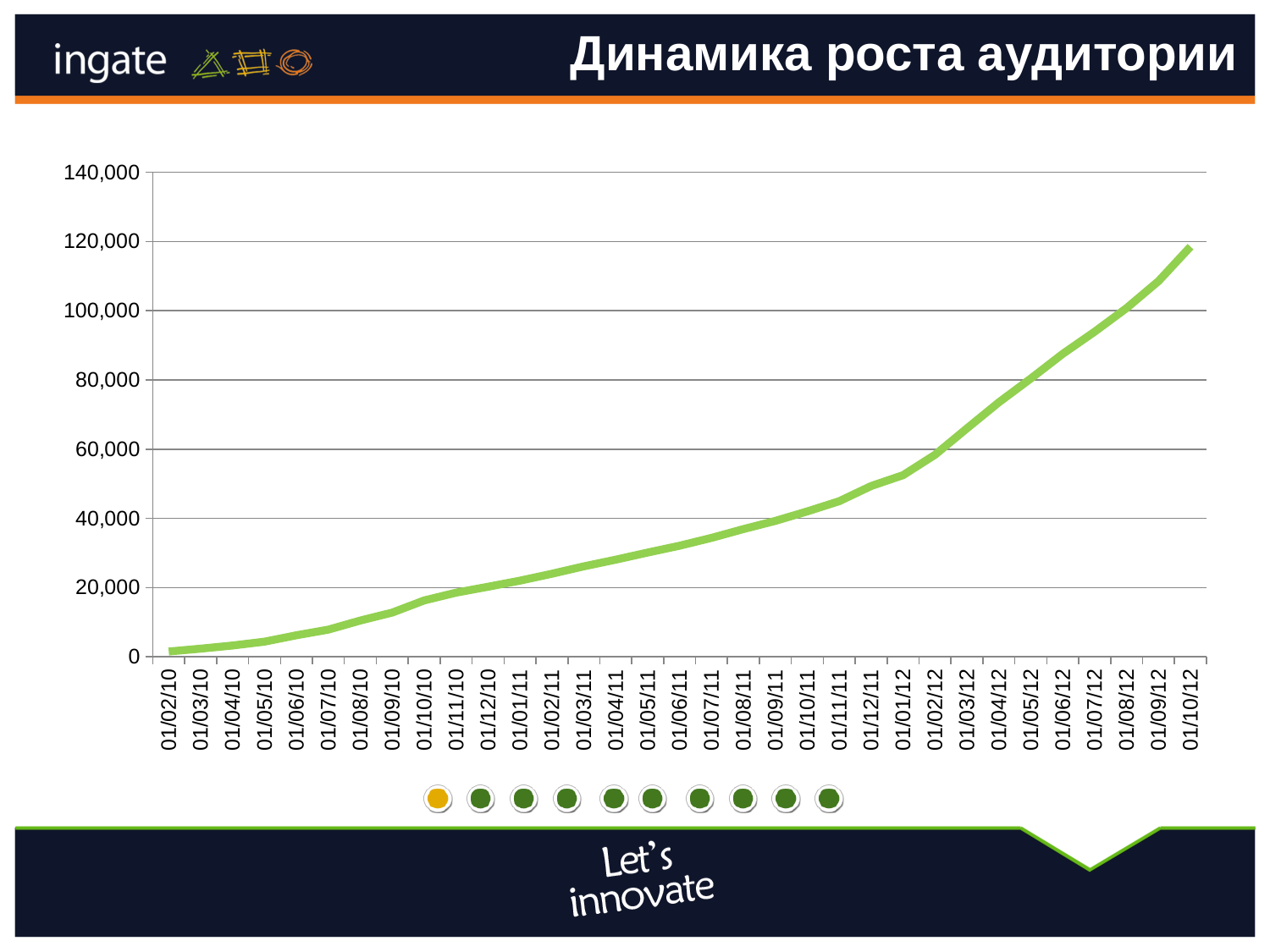
At which date is the plotted value lowest? 01/02/10 What is the title of the chart? Динамика роста аудитории Is the value for 01/01/12 greater or less than 60,000? less Which is larger, the value for 01/03/12 or the value for 01/03/11? 01/03/12 At which date is the plotted value highest? 01/10/12 How many data points are plotted on the x axis? 33 Is the value for 01/06/12 greater or less than 80,000? greater What kind of chart is shown on the slide? line chart What colour is the plotted line? green Is the value for 01/10/12 greater or less than 100,000? greater Do the values rise or fall along the x axis from 01/02/10 to 01/10/12? rise